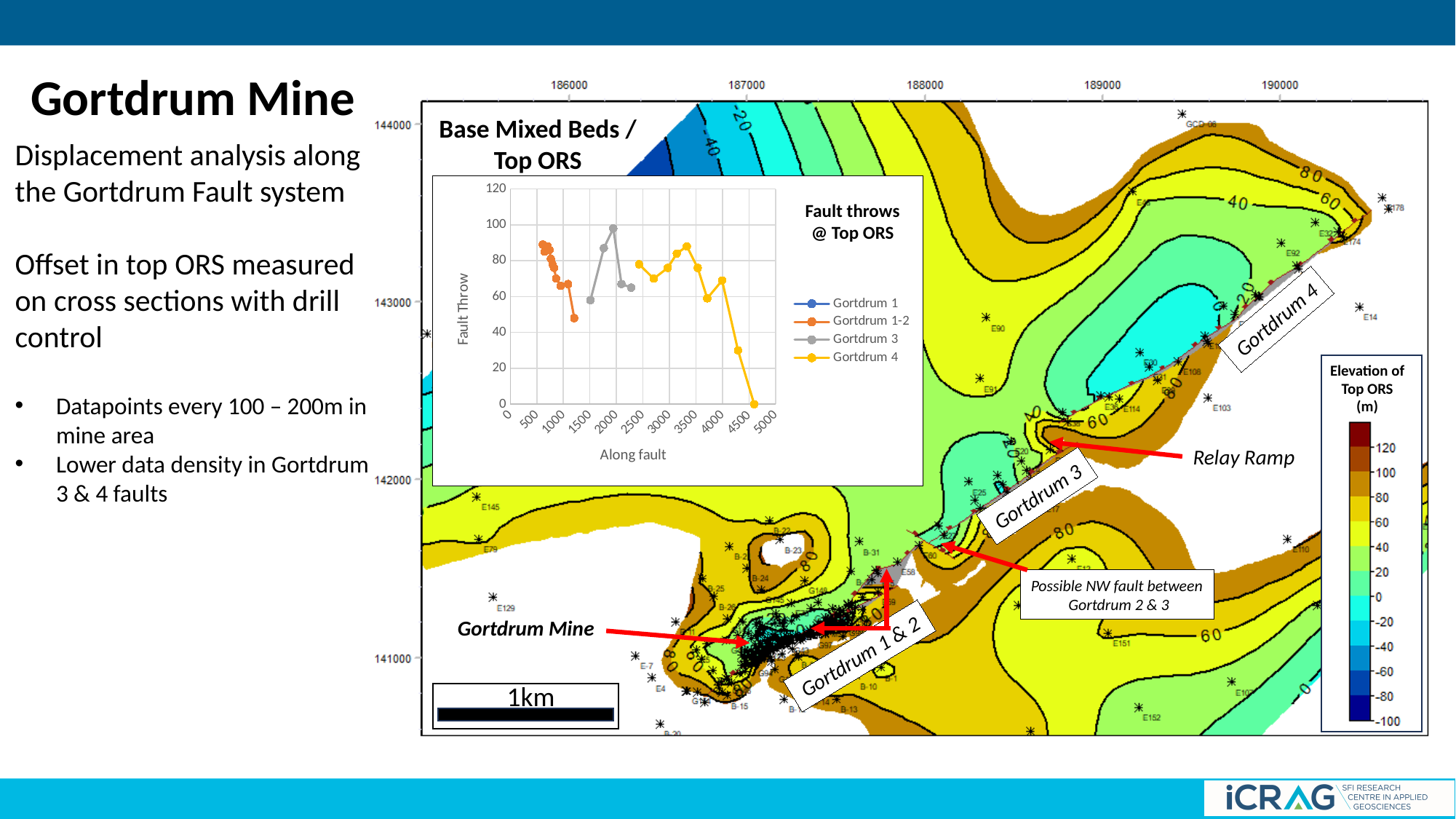
What is the label of the vertical axis on the 'Fault throws @ Top ORS' chart? Fault Throw On the 'Fault throws @ Top ORS' chart, is the peak of the Gortdrum 3 series higher or lower than the peak of the Gortdrum 4 series? higher On the 'Fault throws @ Top ORS' chart, is the final point of the Gortdrum 4 series (near 4700 along fault) greater or less than 20? less On the 'Fault throws @ Top ORS' chart, is the peak value of the Gortdrum 3 series greater or less than 80? greater What is the label of the horizontal axis on the 'Fault throws @ Top ORS' chart? Along fault On the 'Fault throws @ Top ORS' chart, do the Gortdrum 1-2 values generally rise or fall as distance along the fault increases? fall On the 'Fault throws @ Top ORS' chart, which series extends furthest along the fault (largest x values)? Gortdrum 4 On the 'Fault throws @ Top ORS' chart, which series contains the lowest fault throw value? Gortdrum 4 On the 'Fault throws @ Top ORS' chart, is the lowest value of the Gortdrum 1-2 series greater or less than 60? less How many series does the legend of the 'Fault throws @ Top ORS' chart list? 4 What kind of chart is the 'Fault throws @ Top ORS' chart? line chart On the 'Fault throws @ Top ORS' chart, which series reaches the highest fault throw value? Gortdrum 3